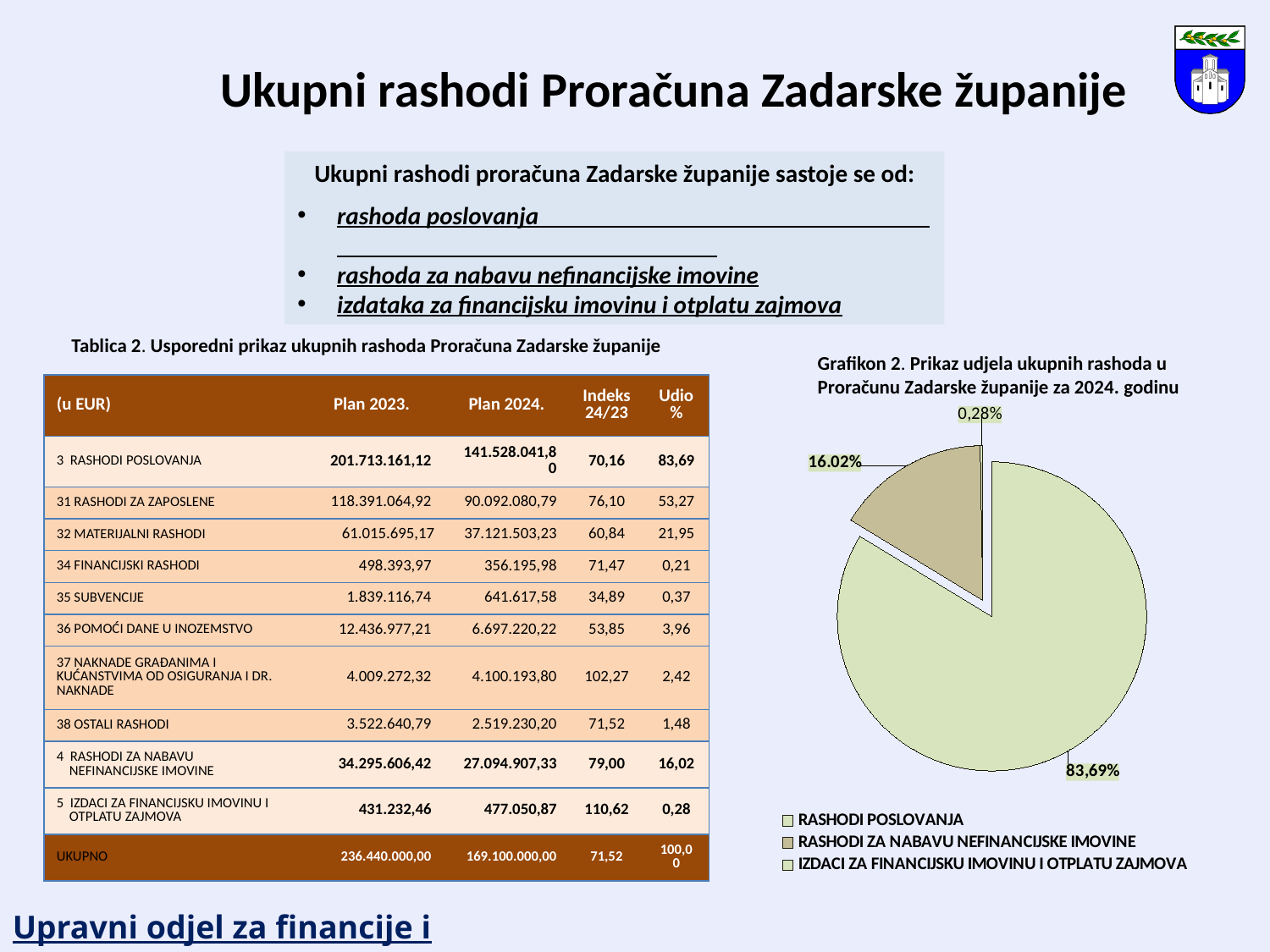
How many entries does the legend of the pie chart list? 3 What share of the pie chart is RASHODI ZA NABAVU NEFINANCIJSKE IMOVINE? 16.02% Which legend entry of the pie chart is listed first? RASHODI POSLOVANJA Which slice is larger in the pie chart: RASHODI ZA NABAVU NEFINANCIJSKE IMOVINE or IZDACI ZA FINANCIJSKU IMOVINU I OTPLATU ZAJMOVA? RASHODI ZA NABAVU NEFINANCIJSKE IMOVINE Which category has the largest slice in the pie chart? RASHODI POSLOVANJA How many slices does the pie chart have? 3 What share of the pie chart is IZDACI ZA FINANCIJSKU IMOVINU I OTPLATU ZAJMOVA? 0,28% What share of the pie chart is RASHODI POSLOVANJA? 83,69% Is the share for RASHODI POSLOVANJA in the pie chart greater or less than 50%? greater What kind of chart is shown on the slide? pie chart Which category has the smallest slice in the pie chart? IZDACI ZA FINANCIJSKU IMOVINU I OTPLATU ZAJMOVA What is the title of the pie chart? Grafikon 2. Prikaz udjela ukupnih rashoda u Proračunu Zadarske županije za 2024. godinu